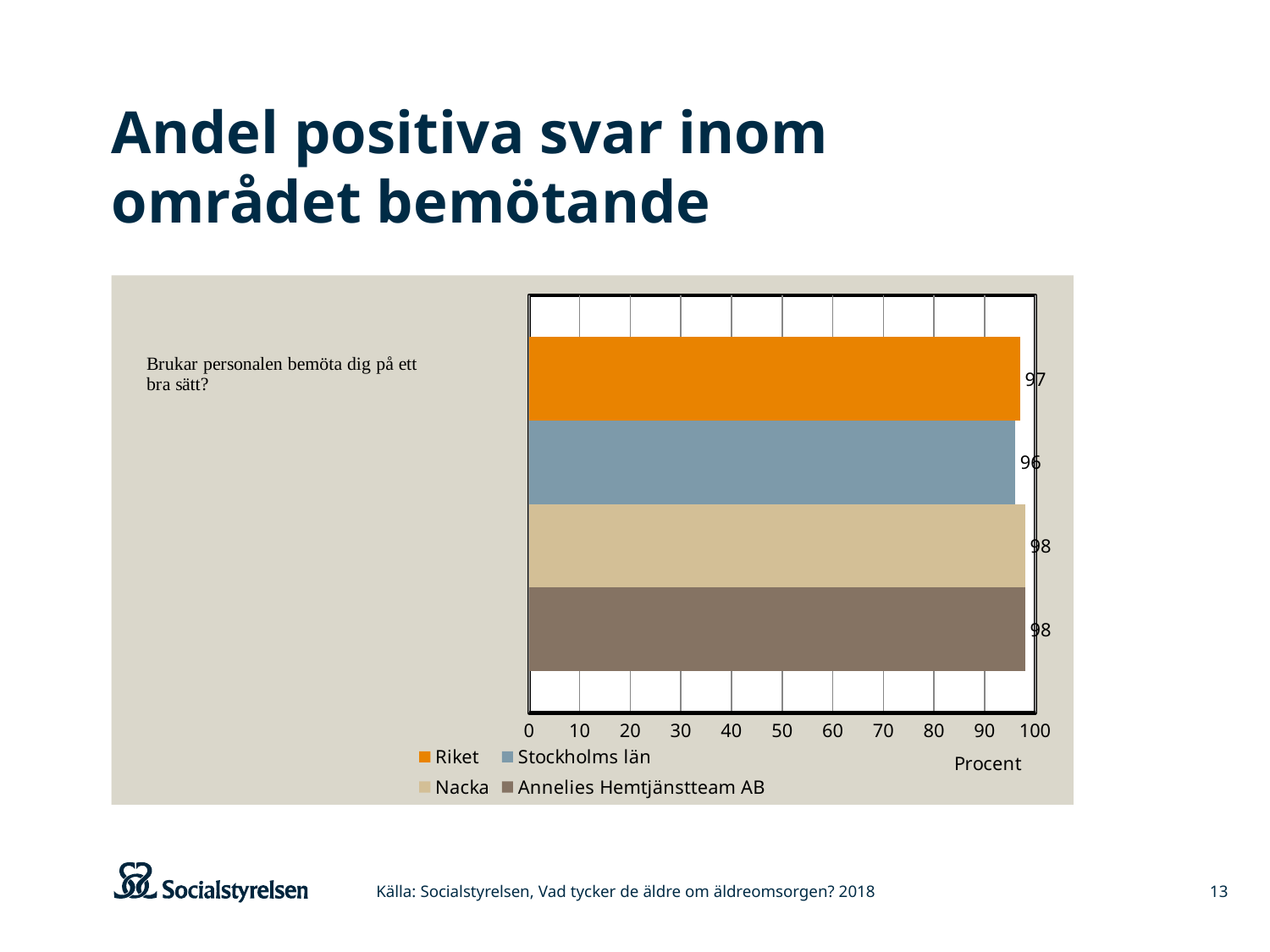
What is the value for Riket in the chart? 97 What is the difference between the values for Riket and Stockholms län? 1 What is the value for Annelies Hemtjänstteam AB in the chart? 98 How many series does the legend list? 4 Which is larger, the value for Riket or the value for Stockholms län? Riket What kind of chart is shown on the slide? Bar chart What is the value for Nacka in the chart? 98 What is the value for Stockholms län in the chart? 96 Is the value for Stockholms län greater or less than 90? greater Which series has the lowest value in the chart? Stockholms län What is the difference between the values for Nacka and Stockholms län? 2 What is the label of the x axis of the chart? Procent